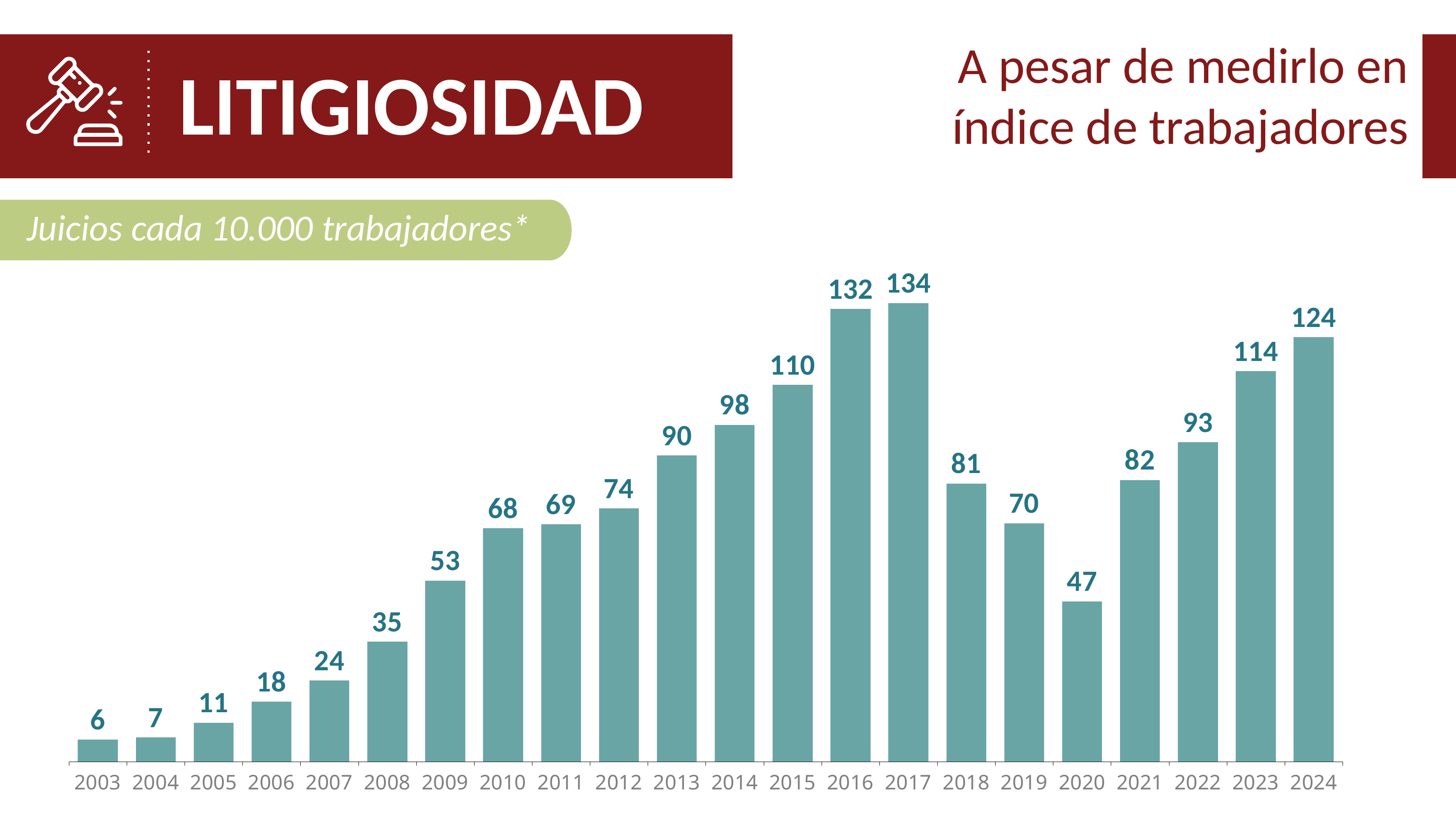
What is the value for 2017? 134 Do the values rise or fall from 2003 to 2017? Rise What is the difference between the values for 2017 and 2018? 53 What is the subtitle describing the unit of the chart? Juicios cada 10.000 trabajadores* How many years are shown on the x axis? 22 Which year has the lowest value? 2003 What kind of chart is this? Bar chart Which is larger, the value for 2016 or the value for 2024? 2016 Which year has the highest value? 2017 What is the value for 2024? 124 What is the difference between the values for 2024 and 2023? 10 What is the value for 2020? 47